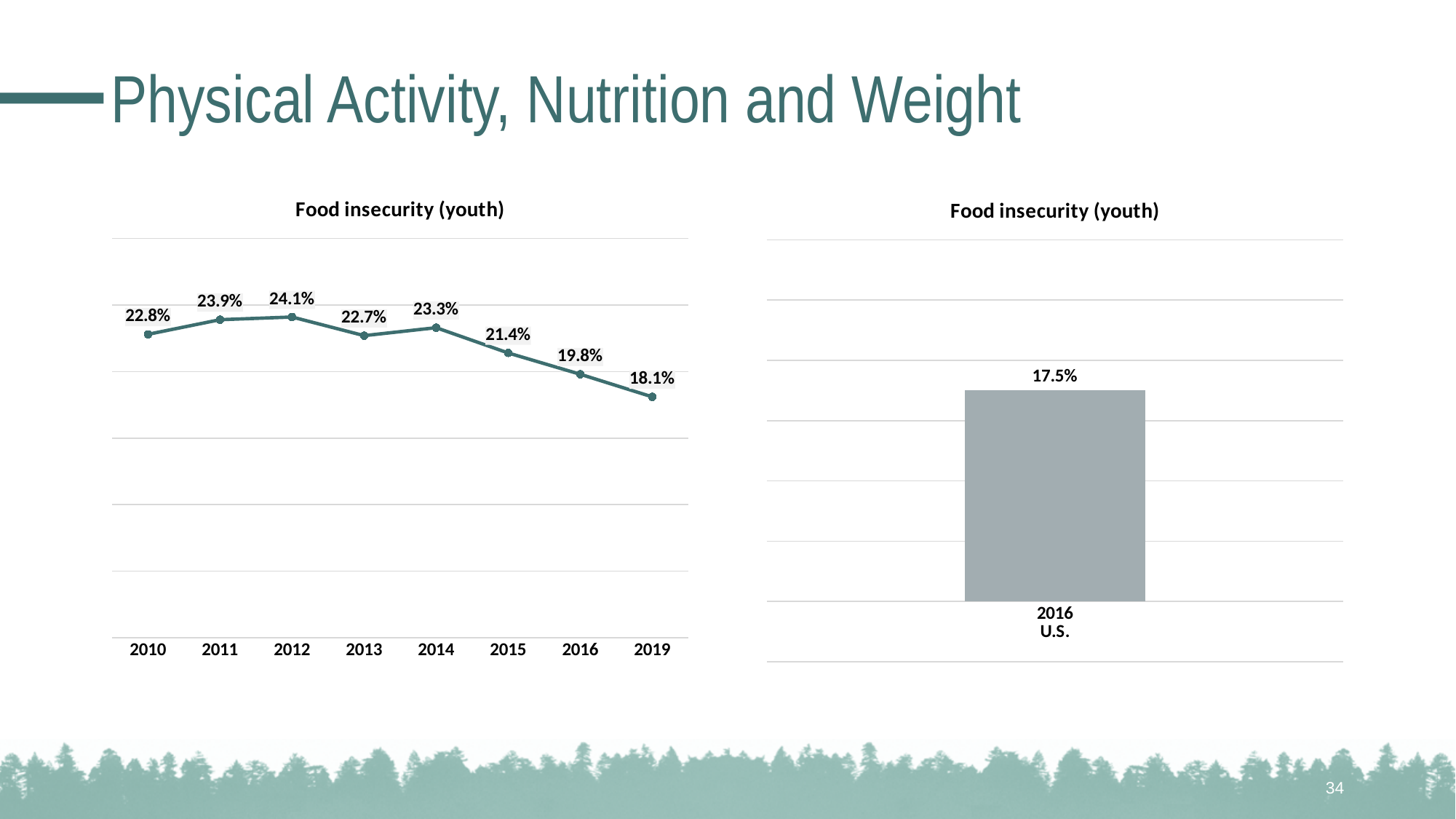
In the left-hand line chart, which year has the lowest food insecurity (youth) value? 2019 How many years are plotted in the left-hand line chart? 8 In the left-hand line chart, what is the difference between the 2012 value and the 2019 value? 6.0% In the left-hand line chart, do the values rise or fall from 2014 to 2019? fall In the left-hand line chart, what is the food insecurity (youth) value for 2012? 24.1% What is the title of the left-hand chart? Food insecurity (youth) In the right-hand bar chart, what is the food insecurity (youth) value for 2016 U.S.? 17.5% In the left-hand line chart, which year has the highest food insecurity (youth) value? 2012 What kind of chart is the right-hand chart? bar chart In the left-hand line chart, what is the food insecurity (youth) value for 2019? 18.1% In the left-hand line chart, which is larger, the value for 2014 or the value for 2015? 2014 In the left-hand line chart, what is the value for 2016? 19.8%